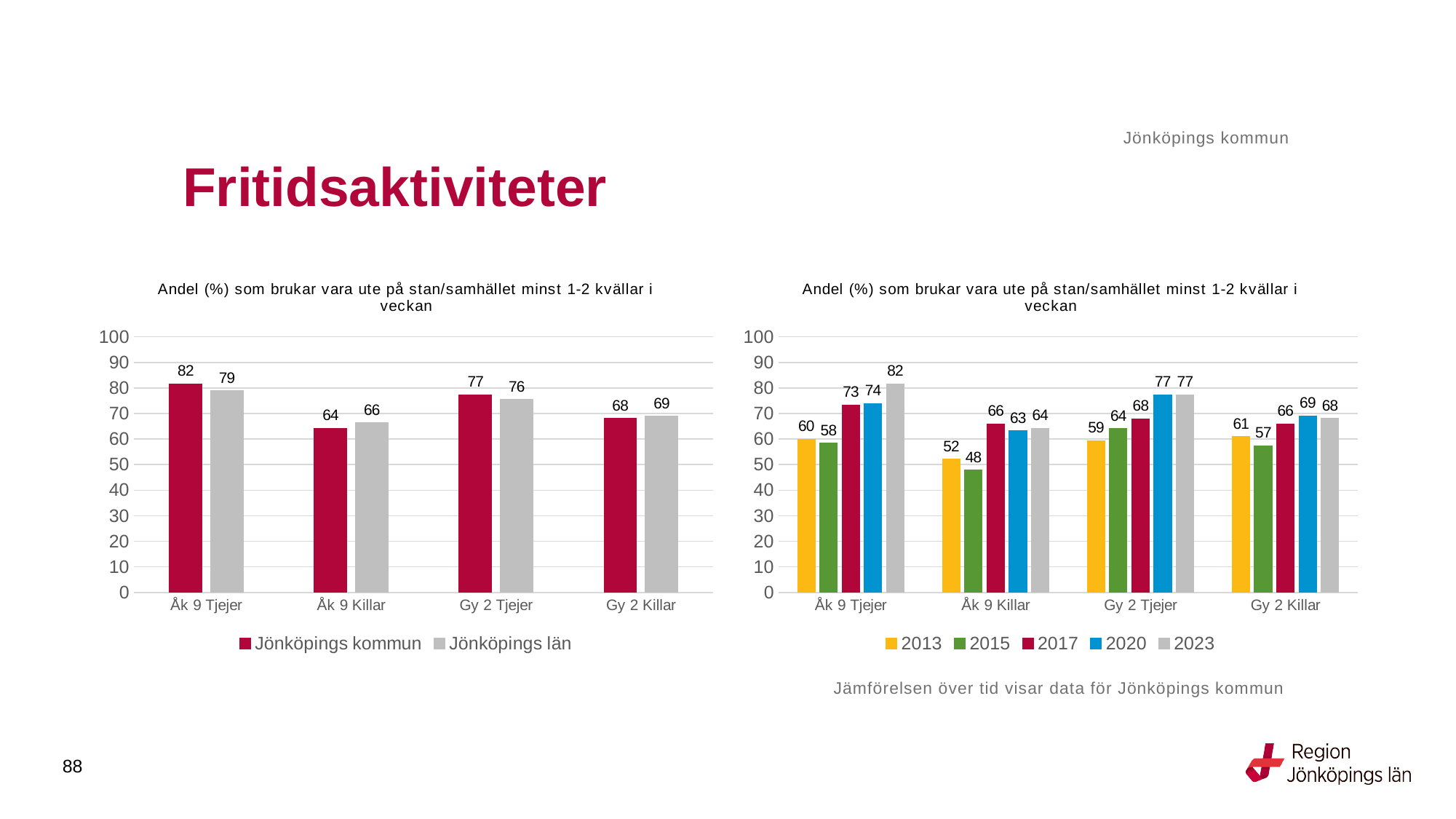
In the left chart, which is larger for Åk 9 Killar: Jönköpings kommun or Jönköpings län? Jönköpings län In the right chart, which year has the highest value for Gy 2 Killar? 2020 How many series does the legend of the right chart list? 5 In the right chart, what is the value for 2015 for Åk 9 Killar? 48 In the right chart, what is the difference between the 2023 and 2013 values for Åk 9 Tjejer? 22 What kind of chart is the right chart? Bar chart In the left chart, what is the value for Jönköpings län for Gy 2 Killar? 69 In the left chart, which category has the lowest value for Jönköpings kommun? Åk 9 Killar In the left chart, what is the difference between Jönköpings kommun and Jönköpings län for Åk 9 Tjejer? 3 In the right chart, what is the value for 2023 for Åk 9 Tjejer? 82 In the left chart, what is the value for Jönköpings kommun for Åk 9 Tjejer? 82 How many series does the legend of the left chart list? 2